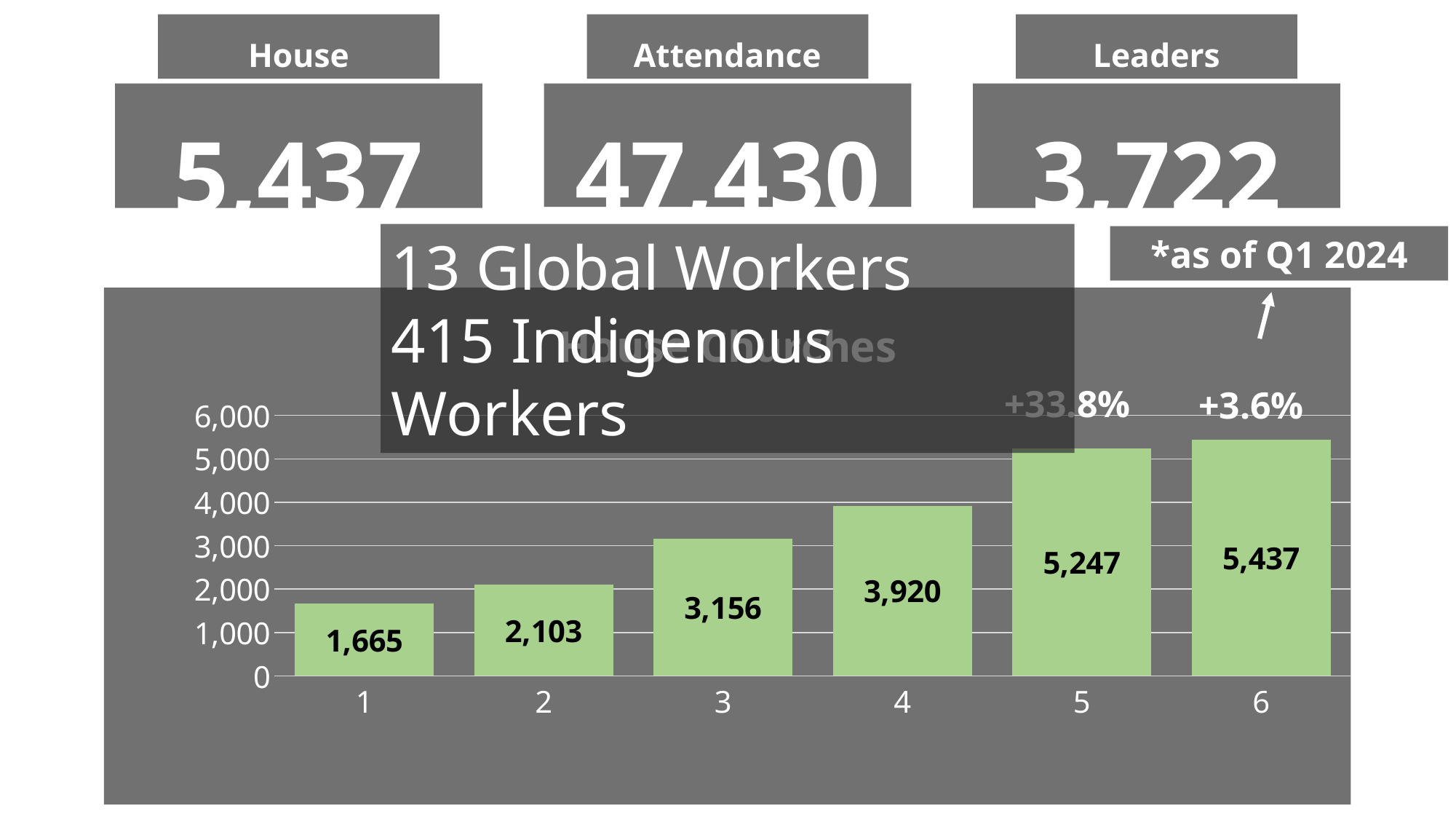
Is the value for category 4 greater or less than 3,000? greater Which category has the highest value in the bar chart? 6 Which is larger, the value for category 2 or the value for category 4? category 4 Which category has the lowest value in the bar chart? 1 What is the value for category 5 in the bar chart? 5,247 How many bars are plotted in the chart? 6 What is the value for category 3 in the bar chart? 3,156 What is the value for category 1 in the bar chart? 1,665 Do the values rise or fall from category 1 to category 6? rise What is the difference between the values for category 4 and category 3? 764 What is the difference between the values for category 6 and category 5? 190 What kind of chart is shown on the slide? bar chart